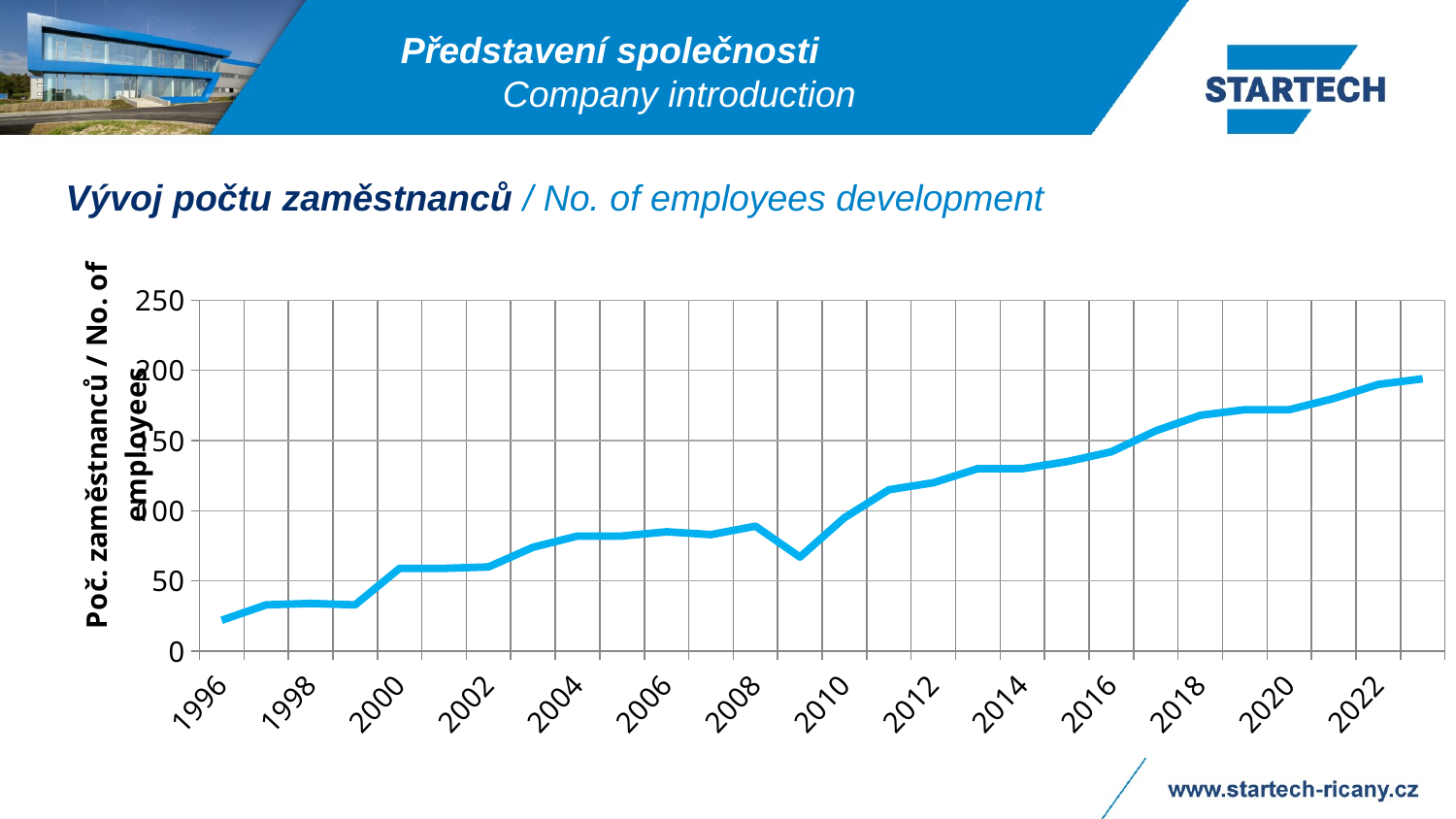
What kind of chart is shown on the slide? line chart Which year has the larger number of employees, 2008 or 2009? 2008 Is the value for 2018 greater or less than 150? greater Is the value for 2008 greater or less than 100? less What is the label of the y axis? Poč. zaměstnanců / No. of employees How many year labels are shown on the x axis? 14 Is the value for 2022 greater or less than 200? less Which year has the lowest number of employees? 1996 Overall, do the values rise or fall from 1996 to 2022? rise